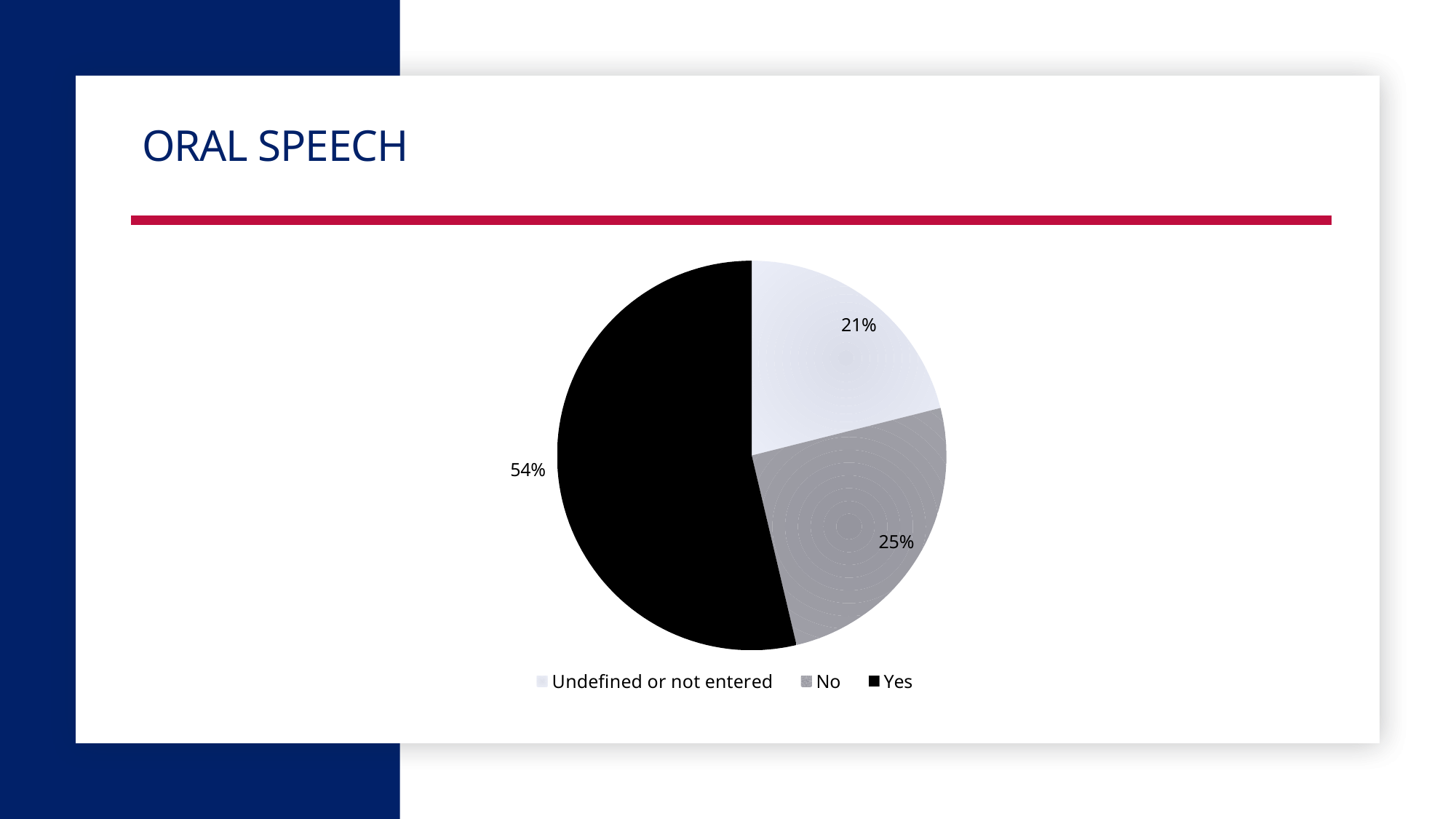
What share of the pie does the "No" slice represent? 25% What is the difference in percentage points between the "No" slice and the "Undefined or not entered" slice? 4 Which is larger, the "No" slice or the "Undefined or not entered" slice? No Which category has the smallest slice of the pie? Undefined or not entered What is the title of the slide containing the pie chart? ORAL SPEECH How many entries does the legend list? 3 What kind of chart is shown on the slide? pie chart What share of the pie does the "Yes" slice represent? 54% What share of the pie does the "Undefined or not entered" slice represent? 21% How many slices does the pie chart have? 3 What is the difference in percentage points between the "Yes" slice and the "No" slice? 29 Which category has the largest slice of the pie? Yes